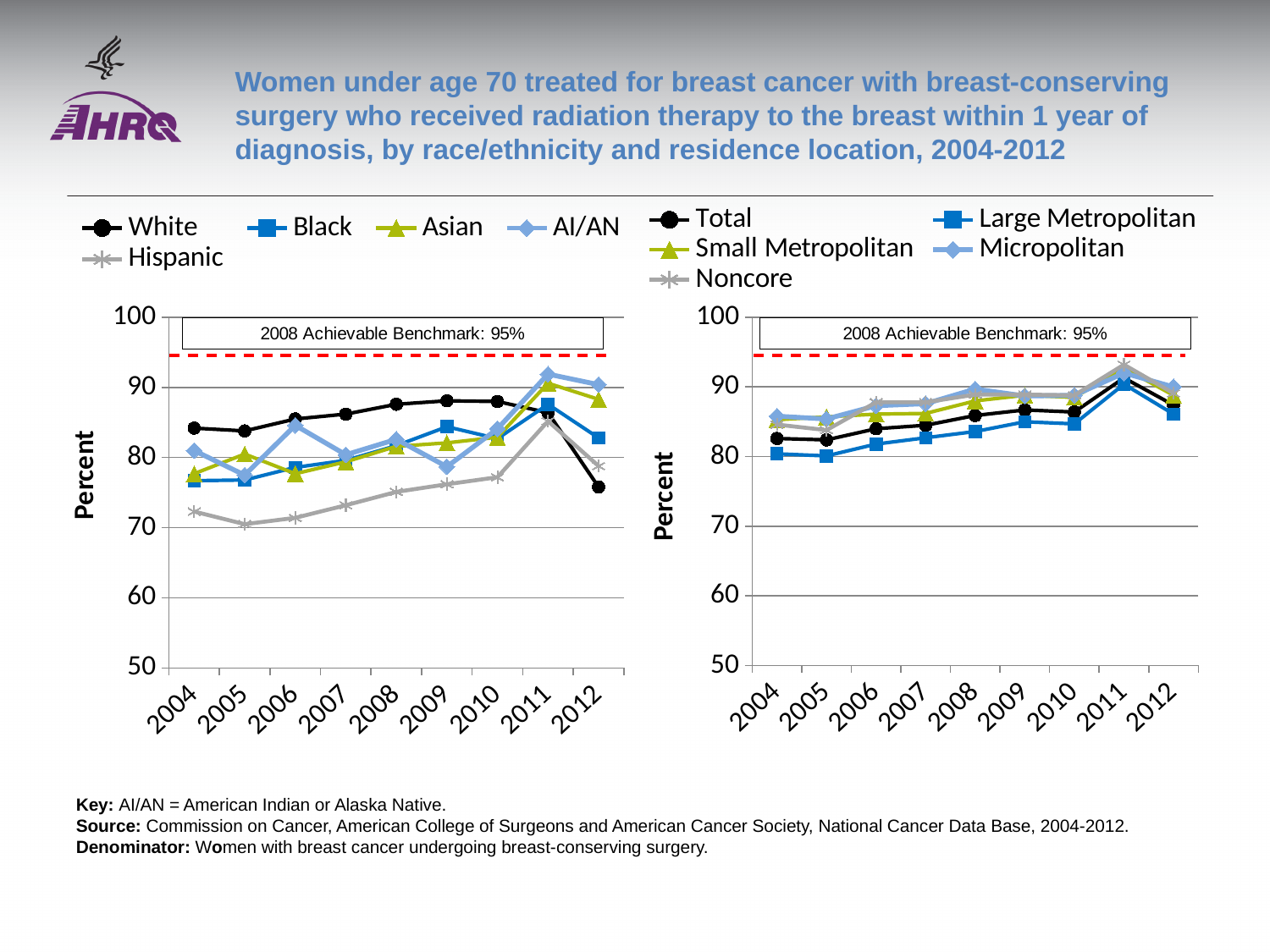
In the left chart (by race/ethnicity), which group has the lowest value in 2004? Hispanic In the left chart (by race/ethnicity), is the value for AI/AN in 2011 greater or less than 90? greater In the right chart (by residence location), which group has the lowest value in 2004? Large Metropolitan In the left chart (by race/ethnicity), is the value for Hispanic in 2004 greater or less than 80? less How many series does the legend of the left chart (by race/ethnicity) list? 5 In the left chart (by race/ethnicity), does the White line rise or fall from 2011 to 2012? Fall What is the 2008 Achievable Benchmark shown on the charts? 95% In the left chart (by race/ethnicity), which group has the highest value in 2004? White How many series does the legend of the right chart (by residence location) list? 5 In the right chart (by residence location), is the value for Noncore in 2011 greater or less than 90? greater What kind of chart is the left chart (by race/ethnicity)? Line chart How many years are shown on the x axis of the right chart (by residence location)? 9